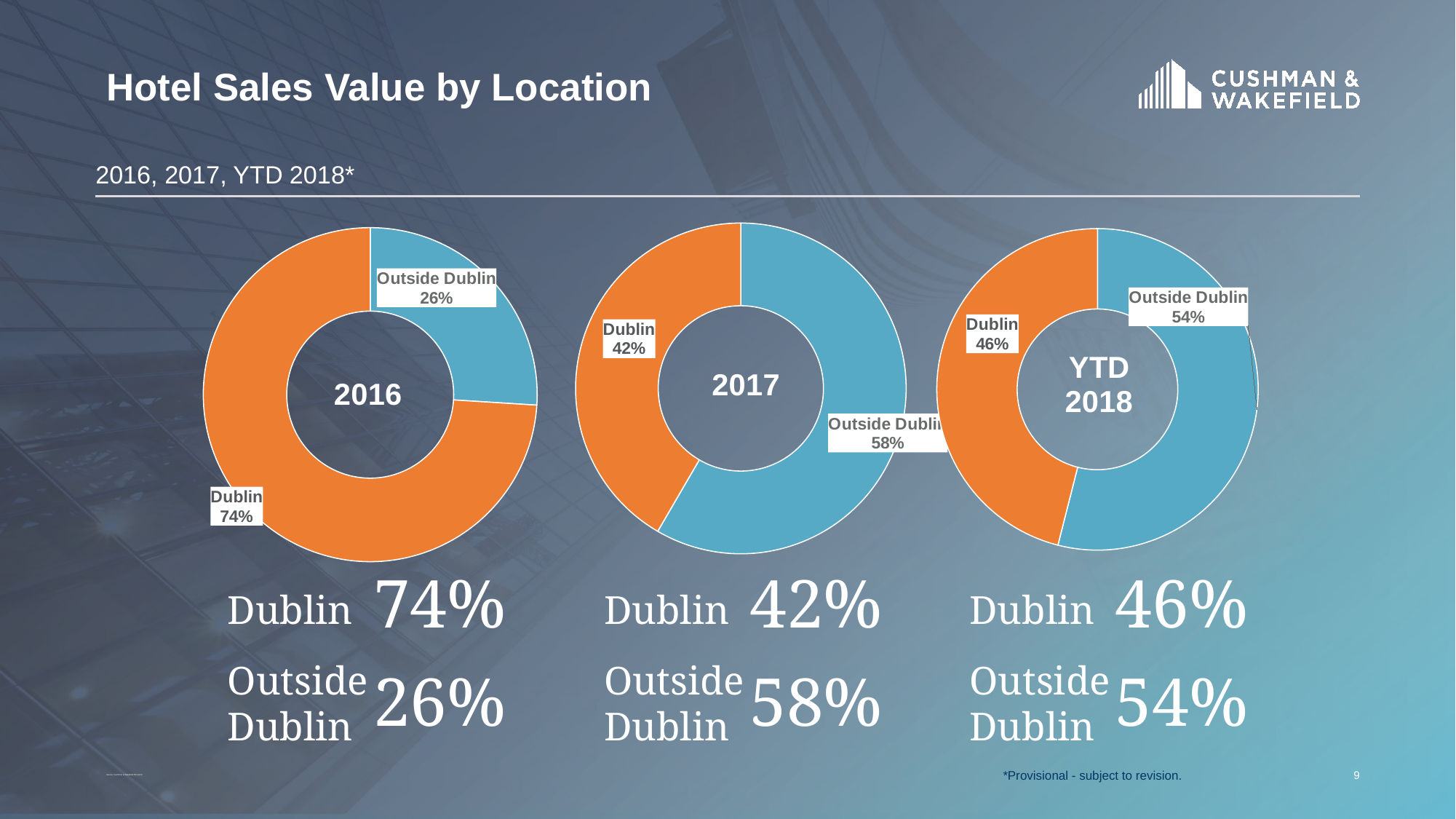
In the 2016 chart, what share of hotel sales value is Dublin? 74% In the 2017 chart, what share of hotel sales value is Outside Dublin? 58% In the YTD 2018 chart, what share of hotel sales value is Outside Dublin? 54% In the 2016 chart, what is the difference between the Dublin and Outside Dublin shares? 48% In the YTD 2018 chart, what share of hotel sales value is Dublin? 46% In the 2017 chart, what share of hotel sales value is Dublin? 42% What kind of chart is used on this slide? Pie chart (doughnut) How many charts are shown on the slide? 3 In the 2017 chart, which location has the smaller share? Dublin In the YTD 2018 chart, which is larger, Dublin or Outside Dublin? Outside Dublin In the 2016 chart, which location has the larger share? Dublin In the 2016 chart, what share of hotel sales value is Outside Dublin? 26%